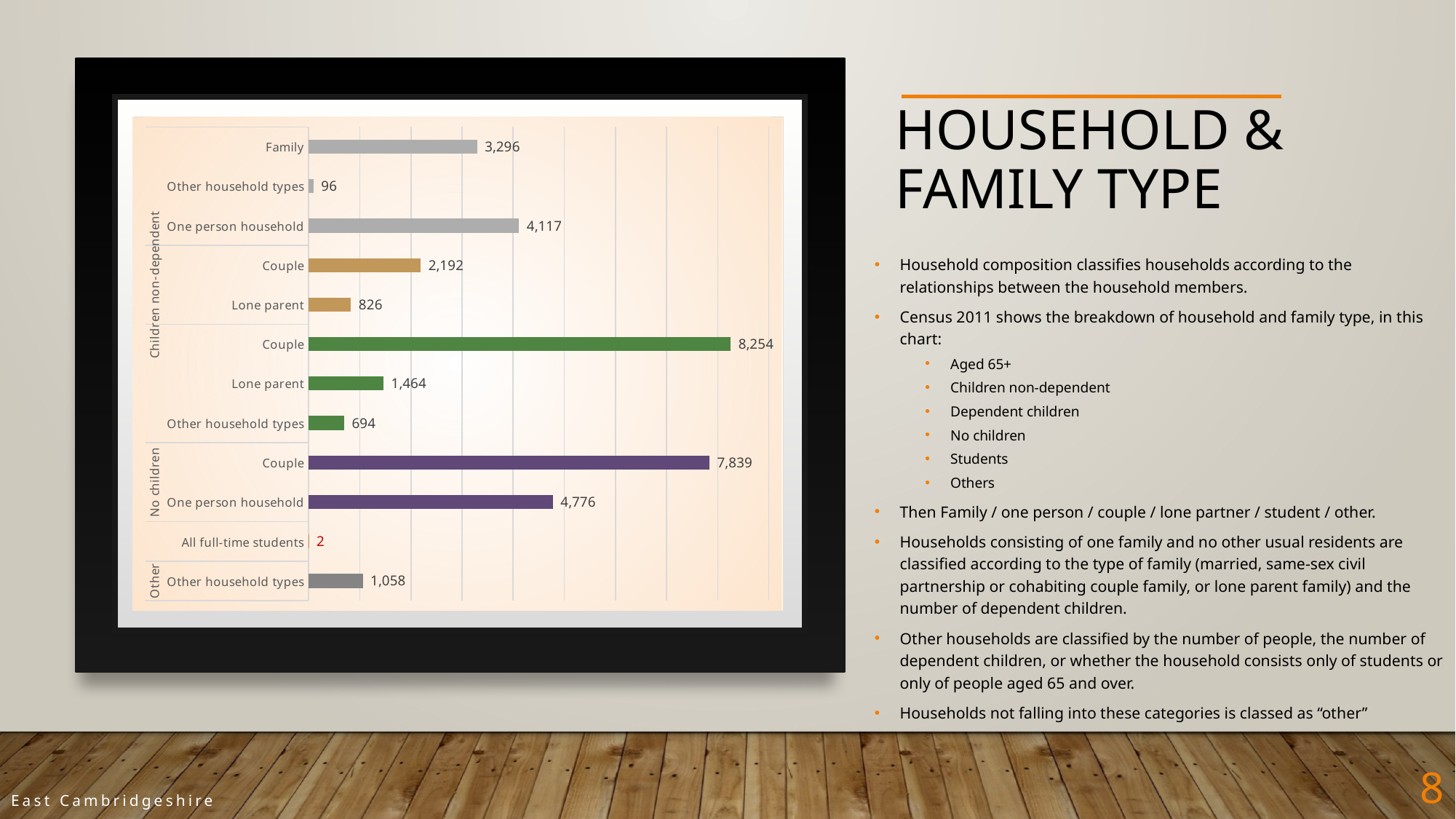
What kind of chart is shown on the slide? bar chart How many bars are plotted in the chart? 12 What is the value of the green Lone parent bar? 1,464 What is the value for All full-time students? 2 What is the value for the Family bar at the top of the chart? 3,296 Which bar has the lowest value in the chart? All full-time students What is the value for Other household types in the Other group? 1,058 In the No children group, what is the difference between Couple and One person household? 3,063 Which bar has the highest value in the chart? Couple (green bar), 8,254 Which is larger: the Family bar or the Other household types bar in the Other group? Family What is the value for Couple in the No children group? 7,839 What is the value for One person household in the No children group? 4,776